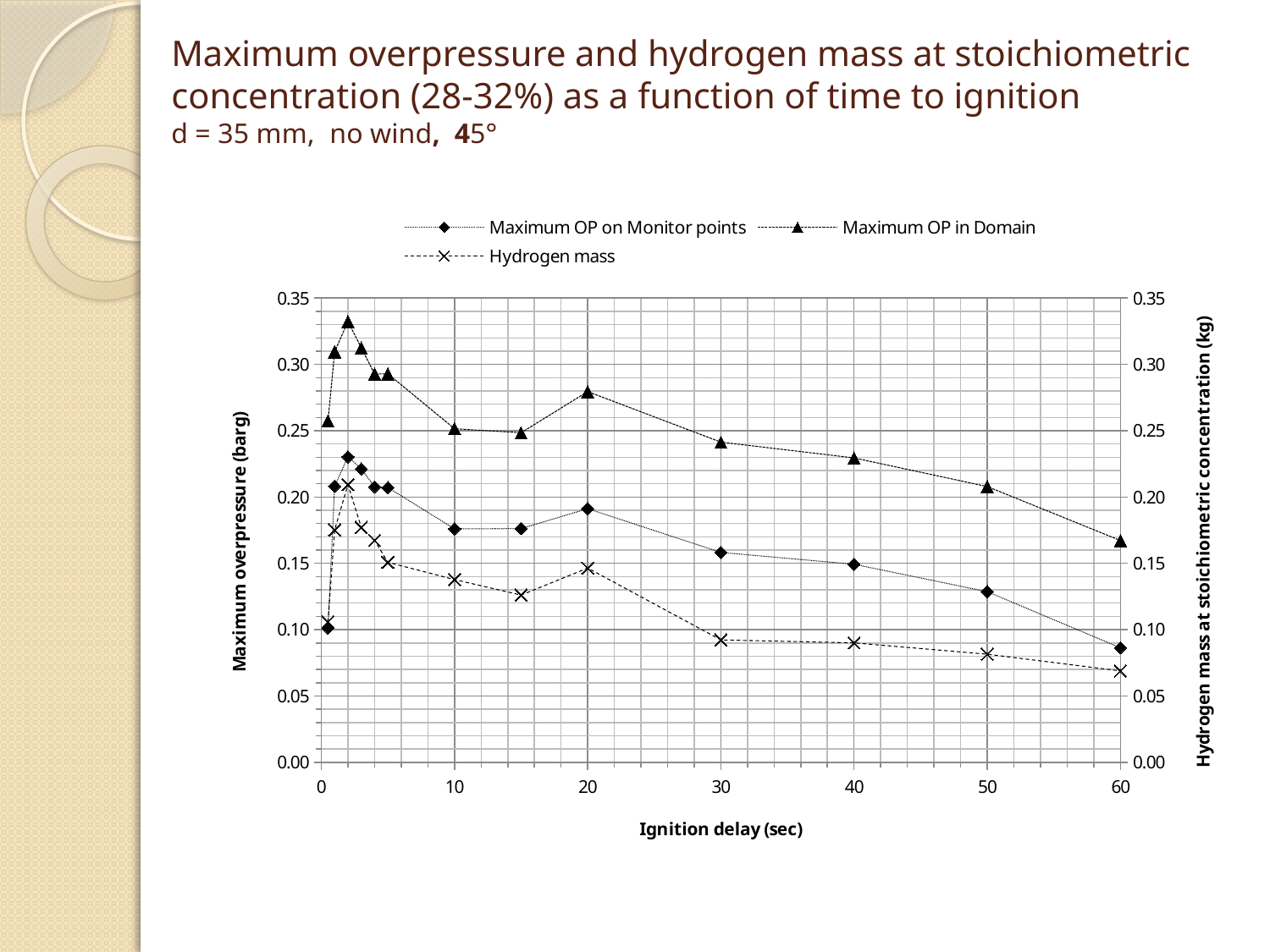
At an ignition delay of 20 sec, which is larger: Maximum OP in Domain or Maximum OP on Monitor points? Maximum OP in Domain Is the value for Hydrogen mass at an ignition delay of 60 sec greater or less than 0.10? less Is the value for Maximum OP in Domain at an ignition delay of 60 sec greater or less than 0.15? greater What kind of chart is shown on the slide? line chart Do the values for Maximum OP in Domain rise or fall from an ignition delay of 20 sec to 60 sec? fall At an ignition delay of 30 sec, which is larger: Maximum OP on Monitor points or Hydrogen mass? Maximum OP on Monitor points What is the title of the left y axis? Maximum overpressure (barg) Is the value for Maximum OP on Monitor points at an ignition delay of 10 sec greater or less than 0.15? greater How many series does the legend list? 3 Which series has the highest values across the chart? Maximum OP in Domain What is the title of the x axis? Ignition delay (sec)